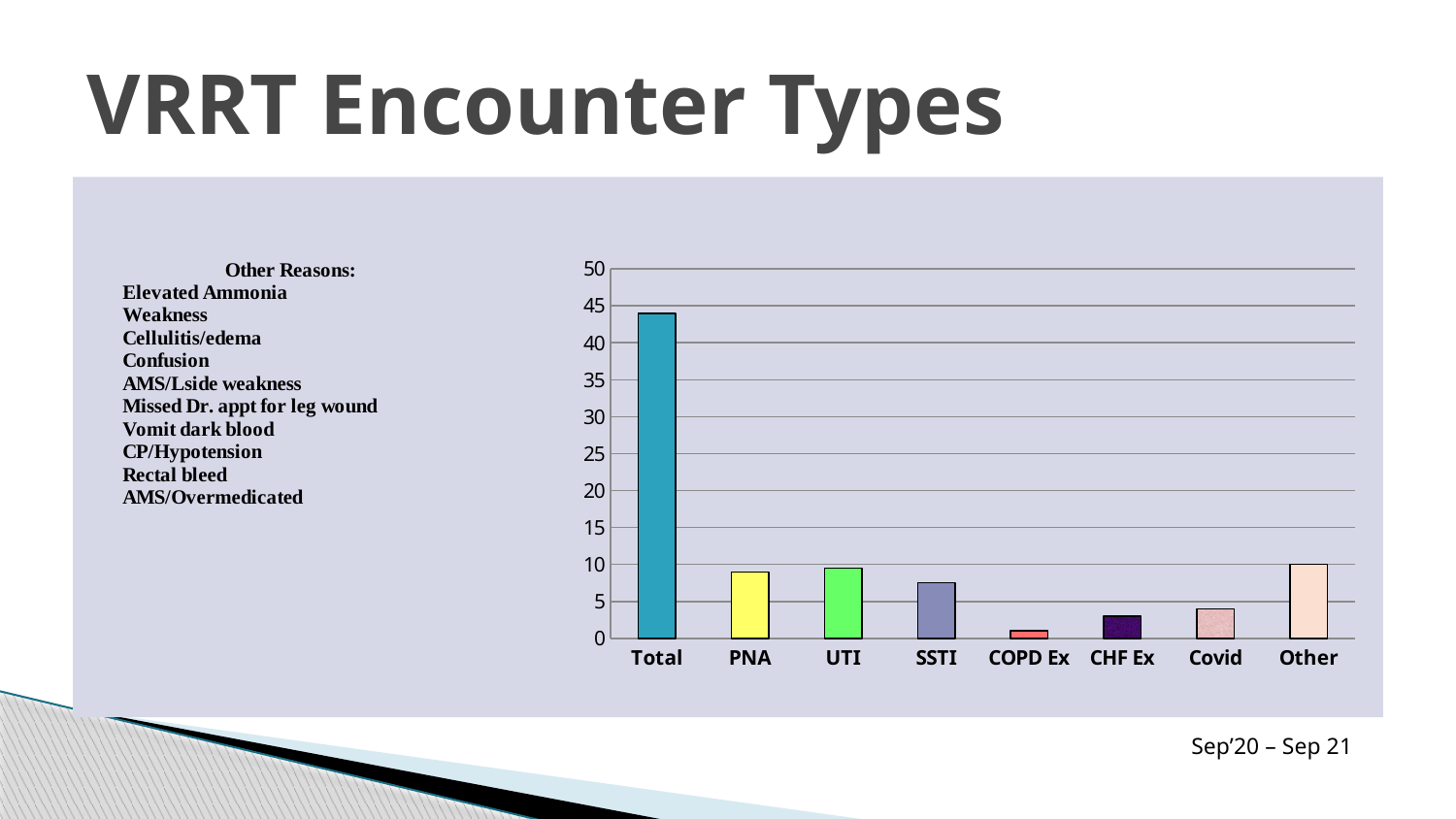
What kind of chart is shown on the slide? bar chart Which is larger, the value for Other or the value for SSTI? Other What time period does the slide state the chart covers? Sep'20 – Sep 21 Is the value for Total greater or less than 40? greater Is the value for SSTI greater or less than 5? greater Is the value for PNA greater or less than 10? less Which category has the highest bar in the chart? Total Which is larger, the value for UTI or the value for CHF Ex? UTI How many categories are shown on the x axis of the chart? 8 Which category has the lowest bar in the chart? COPD Ex